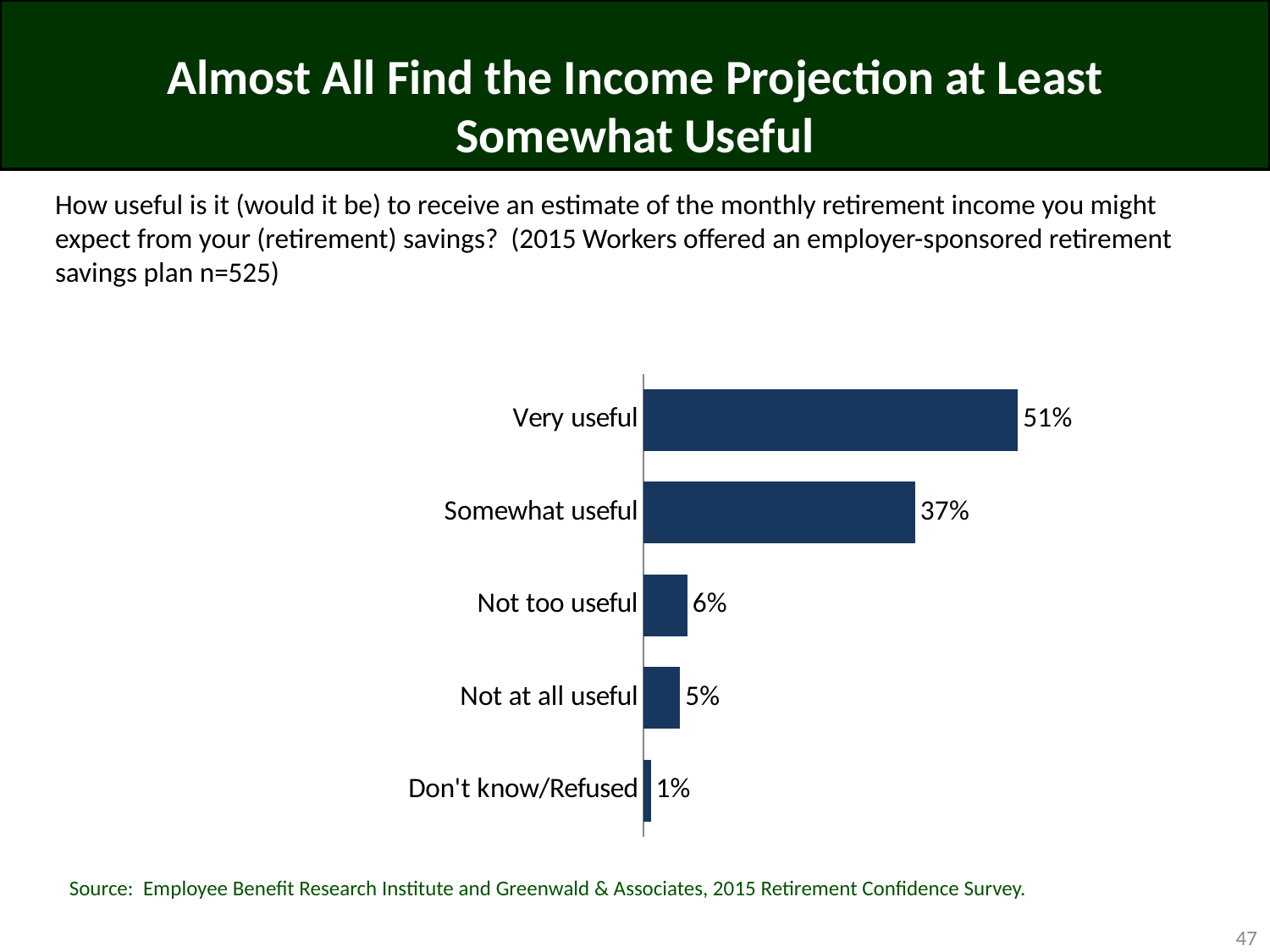
What is the sample size (n) stated in the question text above the chart? 525 What is the value for Somewhat useful? 37% What is the difference between the Very useful and Somewhat useful values? 14 percentage points What is the value for Not too useful? 6% How many categories are shown in the chart? 5 What is the value for Don't know/Refused? 1% Which category has the highest value? Very useful Which category has the lowest value? Don't know/Refused What kind of chart is shown on the slide? Bar chart What percentage of workers said the income projection would be very useful? 51% Which is larger, the value for Not too useful or the value for Not at all useful? Not too useful What is the combined value of Very useful and Somewhat useful? 88%